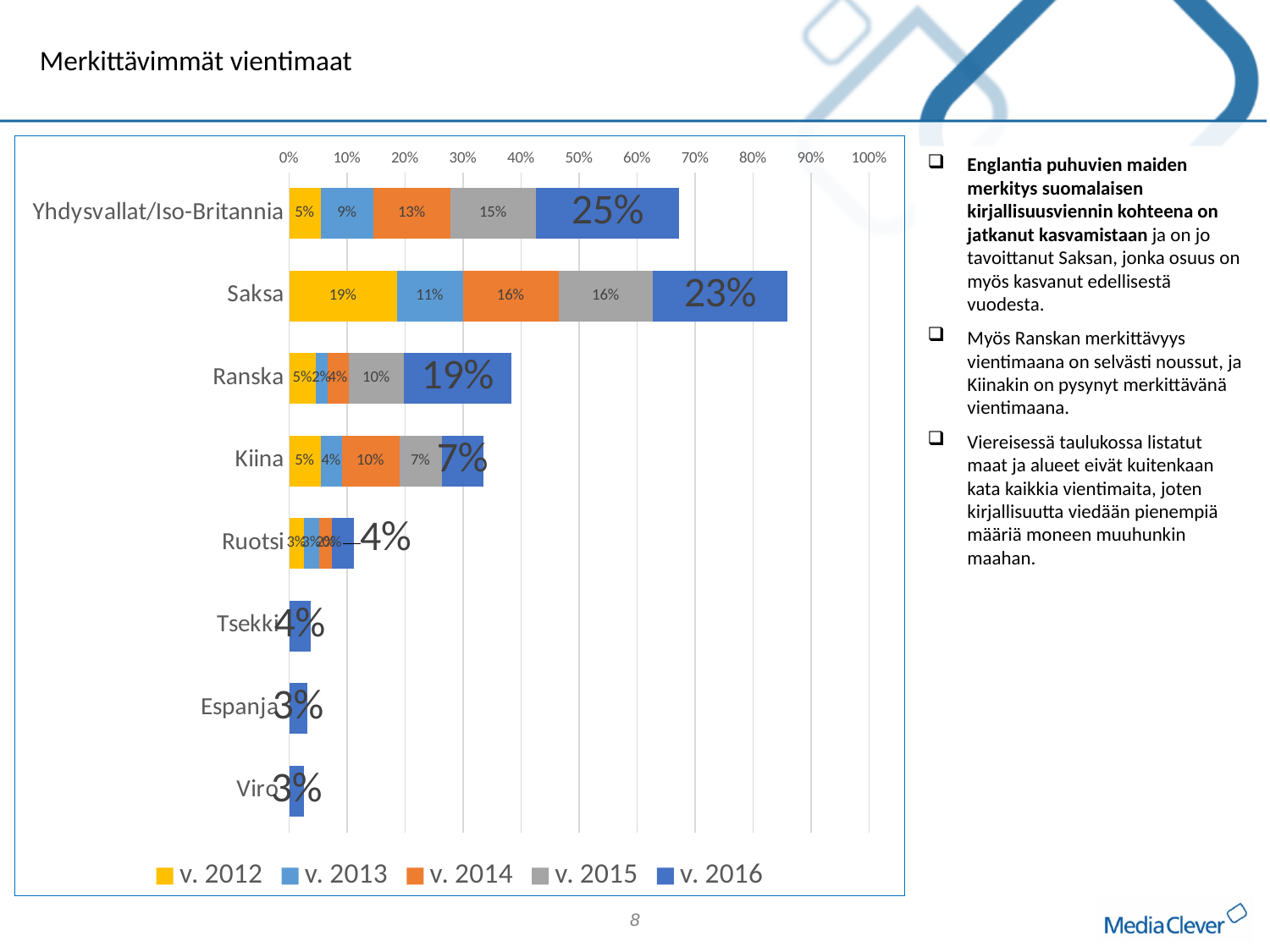
What is the v. 2016 value for Ranska? 19% How many countries or regions are shown on the chart? 8 What is the v. 2016 value for Yhdysvallat/Iso-Britannia? 25% What is the v. 2012 value for Saksa? 19% What is the total of the stacked bar for Saksa? 85% How many series does the legend list? 5 Which country has the highest v. 2016 value? Yhdysvallat/Iso-Britannia What is the v. 2014 value for Kiina? 10% What is the difference between the v. 2016 values for Saksa and Ranska? 4% Which series is shown in orange in the legend? v. 2014 Which is larger, the v. 2015 value for Saksa or the v. 2015 value for Yhdysvallat/Iso-Britannia? Saksa What kind of chart is shown on the slide? stacked bar chart